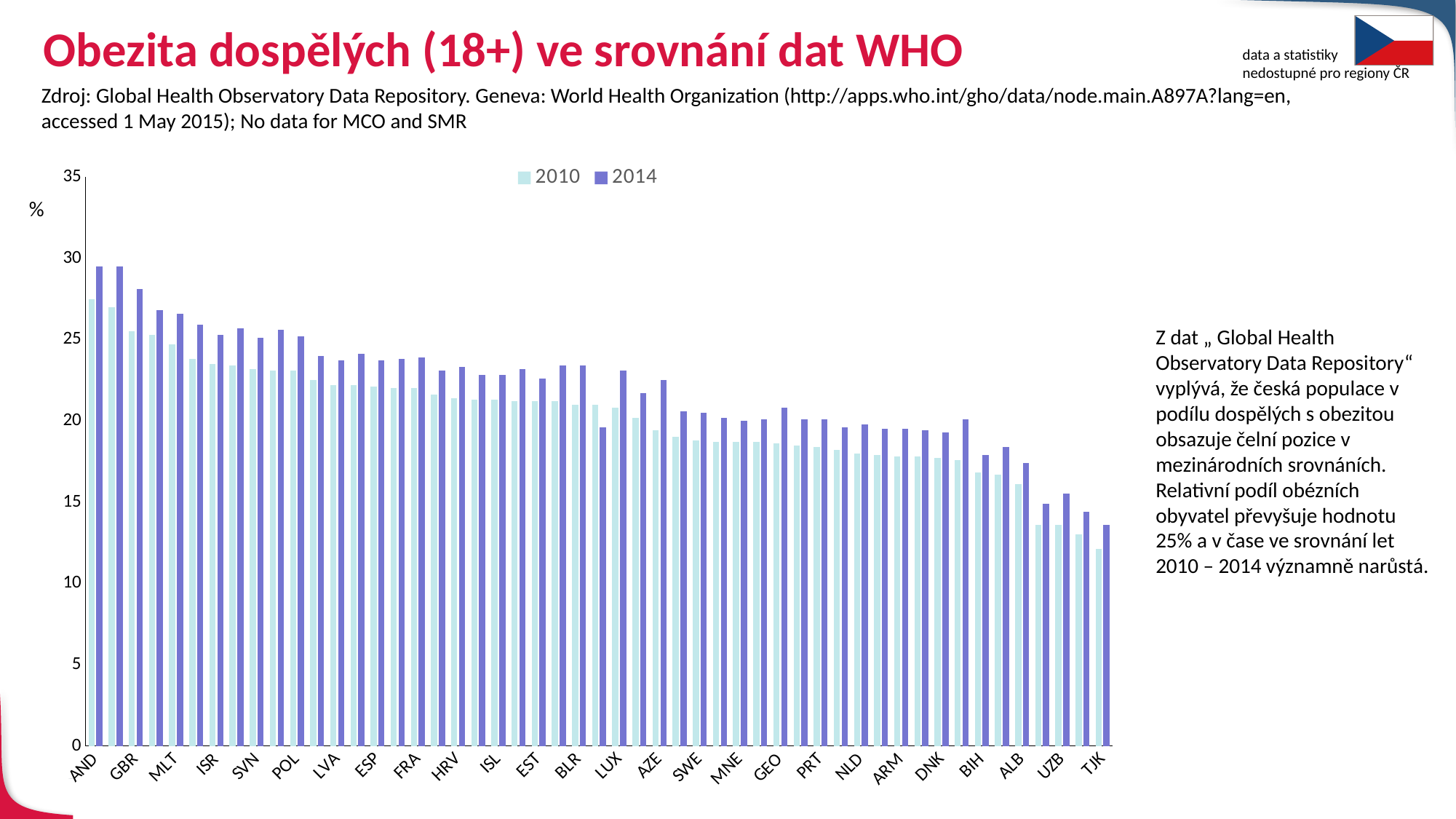
Is the 2014 value for AND greater or less than 25? greater Is the 2014 value for TJK greater or less than 15? less What unit is shown on the vertical axis of the chart? % Which of the labelled countries has the lowest 2014 value? TJK Do the 2014 values generally rise or fall moving from left to right along the x axis? fall Which two years are listed in the chart legend? 2010 and 2014 Is the 2010 value for TJK greater or less than 15? less Which is larger, the 2014 value for AND or the 2014 value for TJK? AND What kind of chart is shown on the slide? bar chart How many series does the legend list? 2